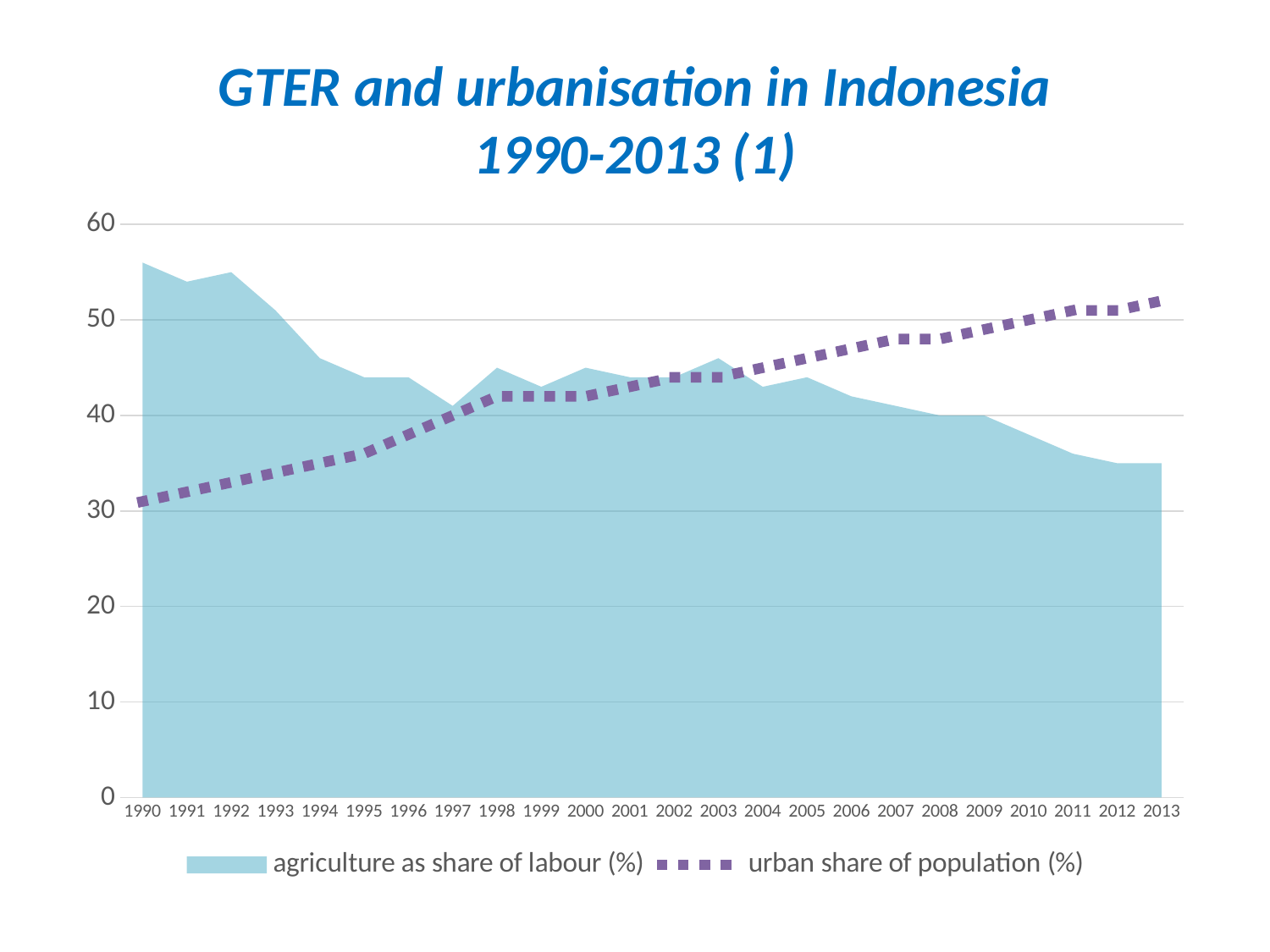
Does agriculture as share of labour (%) rise or fall overall from 1990 to 2013? fall In which year is the urban share of population (%) lowest? 1990 How many series does the legend list? 2 In 2010, which is larger: agriculture as share of labour (%) or urban share of population (%)? urban share of population (%) How many years are shown on the x axis? 24 In which year is the urban share of population (%) highest? 2013 In which year is agriculture as share of labour (%) highest? 1990 Is the value for agriculture as share of labour (%) in 1990 greater or less than 50? greater Does the urban share of population (%) rise or fall from 1990 to 2013? rise What kind of chart is this? combination area and line chart Is the value for urban share of population (%) in 2013 greater or less than 50? greater What is the title of the chart? GTER and urbanisation in Indonesia 1990-2013 (1)